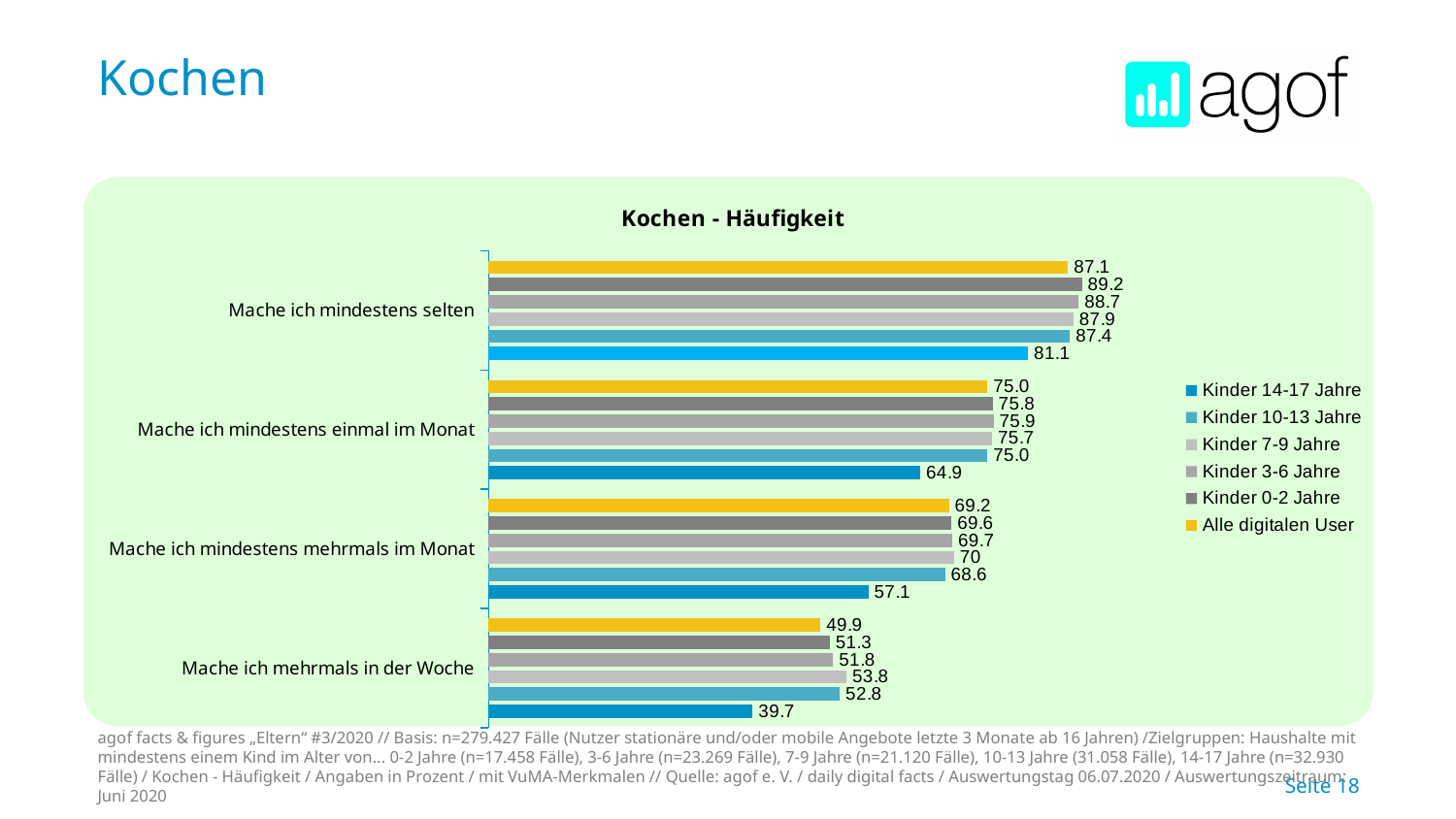
What is the value for Alle digitalen User in the category "Mache ich mindestens selten"? 87.1 Which category has the lowest value for Alle digitalen User? Mache ich mehrmals in der Woche What is the value for Kinder 7-9 Jahre in the category "Mache ich mindestens mehrmals im Monat"? 70 Which series has the highest value in the category "Mache ich mindestens selten"? Kinder 0-2 Jahre How many categories are shown on the chart? 4 What is the title of the chart? Kochen - Häufigkeit Which series has the lowest value in the category "Mache ich mindestens einmal im Monat"? Kinder 14-17 Jahre What type of chart is shown on the slide? bar chart Which is larger in the category "Mache ich mehrmals in der Woche": Kinder 7-9 Jahre or Kinder 10-13 Jahre? Kinder 7-9 Jahre How many series does the legend list? 6 What is the difference between Kinder 0-2 Jahre and Kinder 14-17 Jahre in the category "Mache ich mindestens selten"? 8.1 What is the value for Kinder 14-17 Jahre in the category "Mache ich mehrmals in der Woche"? 39.7